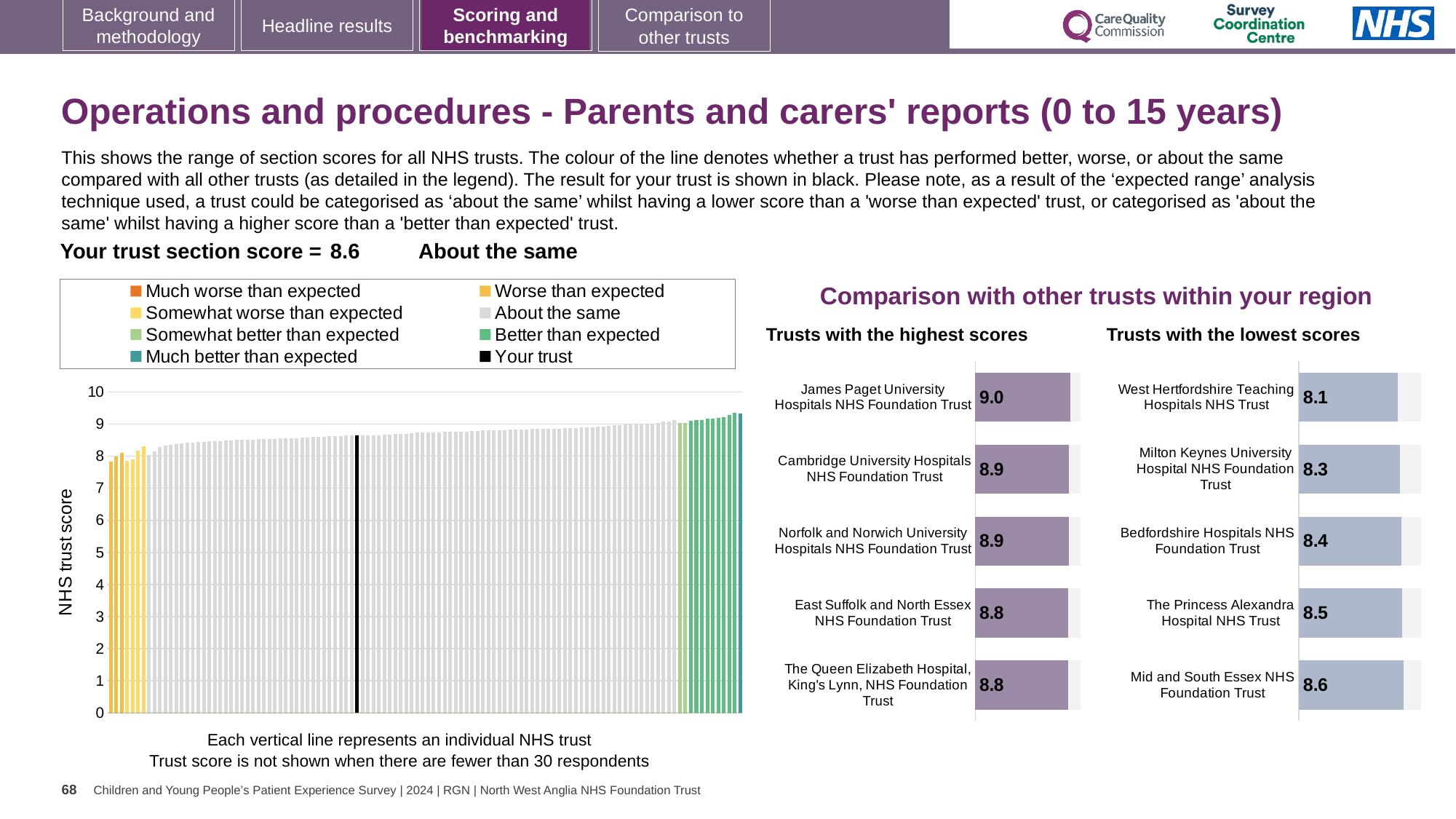
What kind of chart is the main 'NHS trust score' chart on the left of the slide? Bar chart In the 'Trusts with the lowest scores' chart, which trust has the lowest score? West Hertfordshire Teaching Hospitals NHS Trust In the 'Trusts with the highest scores' chart, which trust has the highest score? James Paget University Hospitals NHS Foundation Trust In the 'Trusts with the highest scores' chart, what is the difference between the scores of James Paget University Hospitals NHS Foundation Trust and East Suffolk and North Essex NHS Foundation Trust? 0.2 How many entries does the legend of the main 'NHS trust score' chart on the left list? 8 In the 'Trusts with the lowest scores' chart, what is the difference between the scores of Mid and South Essex NHS Foundation Trust and West Hertfordshire Teaching Hospitals NHS Trust? 0.5 What is the section score for your trust shown on the slide? 8.6 In the 'Trusts with the highest scores' chart, what is the score for James Paget University Hospitals NHS Foundation Trust? 9.0 How many trusts are shown in the 'Trusts with the highest scores' chart? 5 In the 'Trusts with the lowest scores' chart, what is the score for West Hertfordshire Teaching Hospitals NHS Trust? 8.1 In the main 'NHS trust score' chart on the left, do the trust scores rise or fall from left to right? Rise In the 'Trusts with the lowest scores' chart, which has the higher score: Bedfordshire Hospitals NHS Foundation Trust or Milton Keynes University Hospital NHS Foundation Trust? Bedfordshire Hospitals NHS Foundation Trust